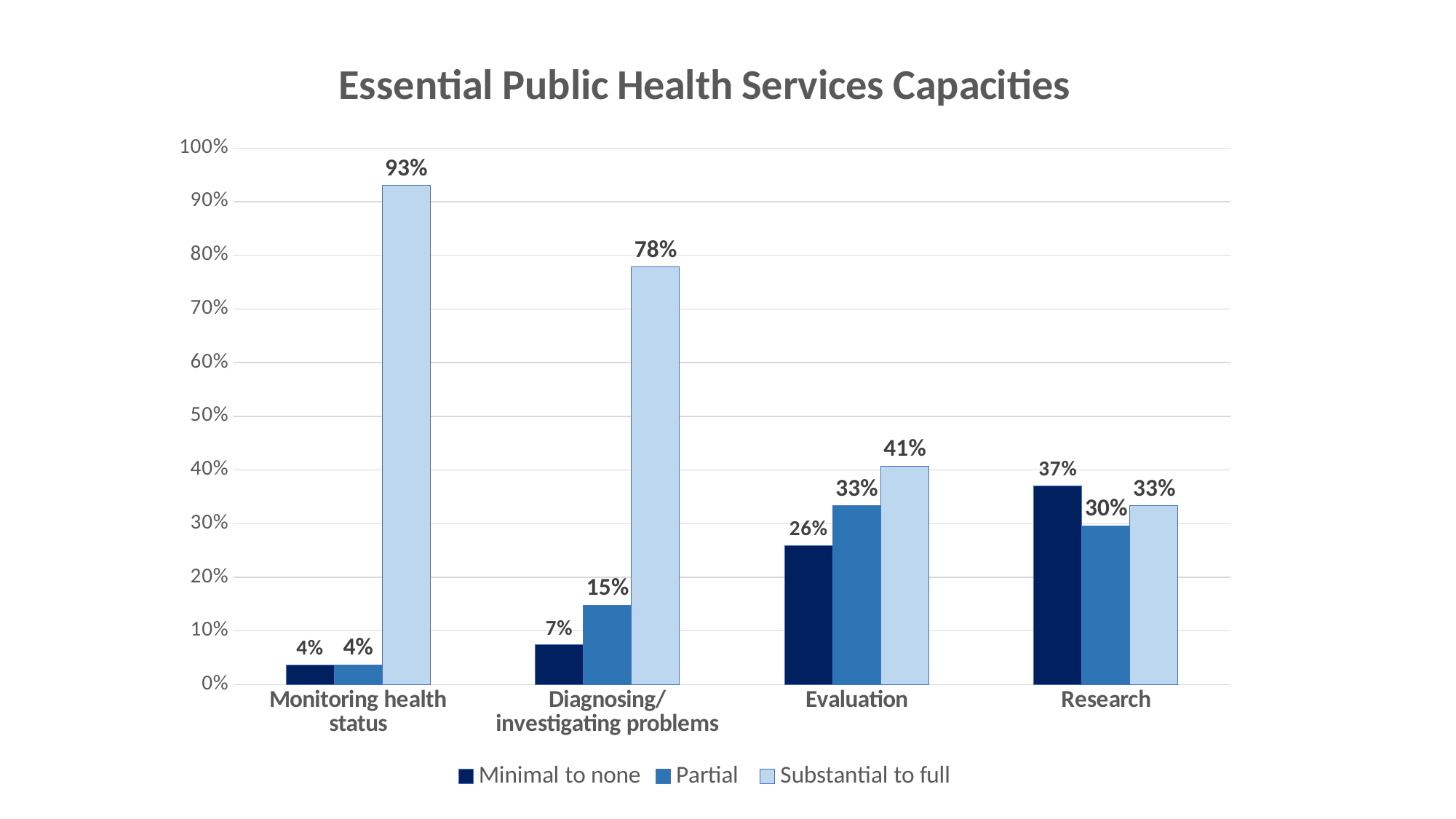
How many series does the legend list? 3 How many categories are shown on the x axis? 4 Is the value for Substantial to full for Evaluation greater or less than 50%? less What kind of chart is this? Bar chart Which category has the lowest value for Minimal to none? Monitoring health status Which category has the highest value for Substantial to full? Monitoring health status Which is larger for Research: Minimal to none or Partial? Minimal to none What is the value for Partial for Diagnosing/investigating problems? 15% What is the difference between the Substantial to full values for Monitoring health status and Diagnosing/investigating problems? 15% What is the value for Substantial to full for Monitoring health status? 93% What is the value for Minimal to none for Research? 37% What is the value for Minimal to none for Evaluation? 26%